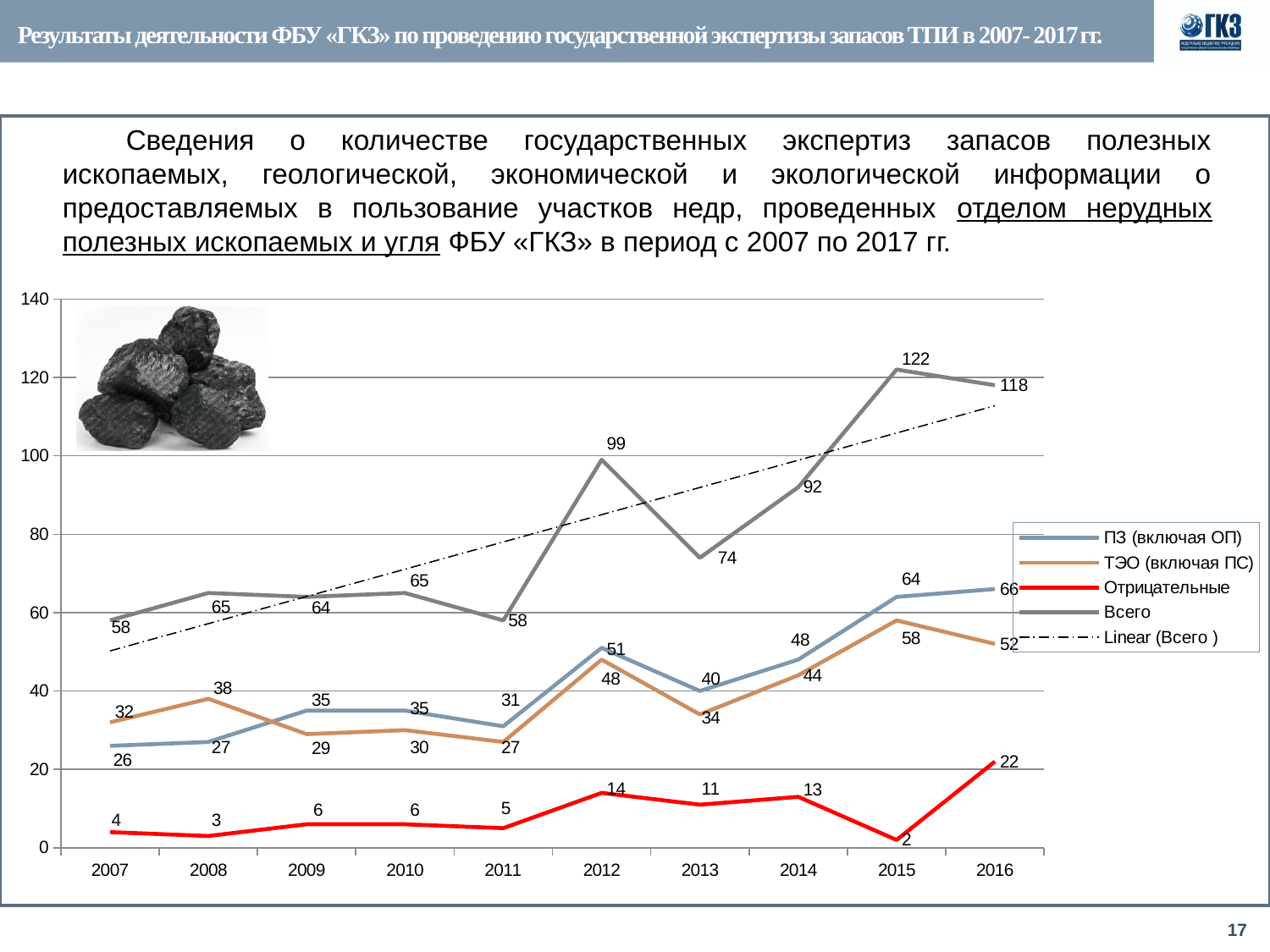
In which year is the Отрицательные series at its lowest value? 2015 Does the ПЗ (включая ОП) series rise or fall from 2013 to 2016? rise Which is larger in 2012: the ПЗ (включая ОП) value or the ТЭО (включая ПС) value? ПЗ (включая ОП) Which series is drawn in red? Отрицательные In which year does the Всего series reach its highest value? 2015 How many years are plotted on the x axis? 10 How many entries does the legend list? 5 What is the value of the Всего series in 2015? 122 What type of chart is shown on the slide? line chart What is the value of the ТЭО (включая ПС) series in 2008? 38 What is the value of the Отрицательные series in 2016? 22 What is the difference between the Всего values in 2015 and 2016? 4